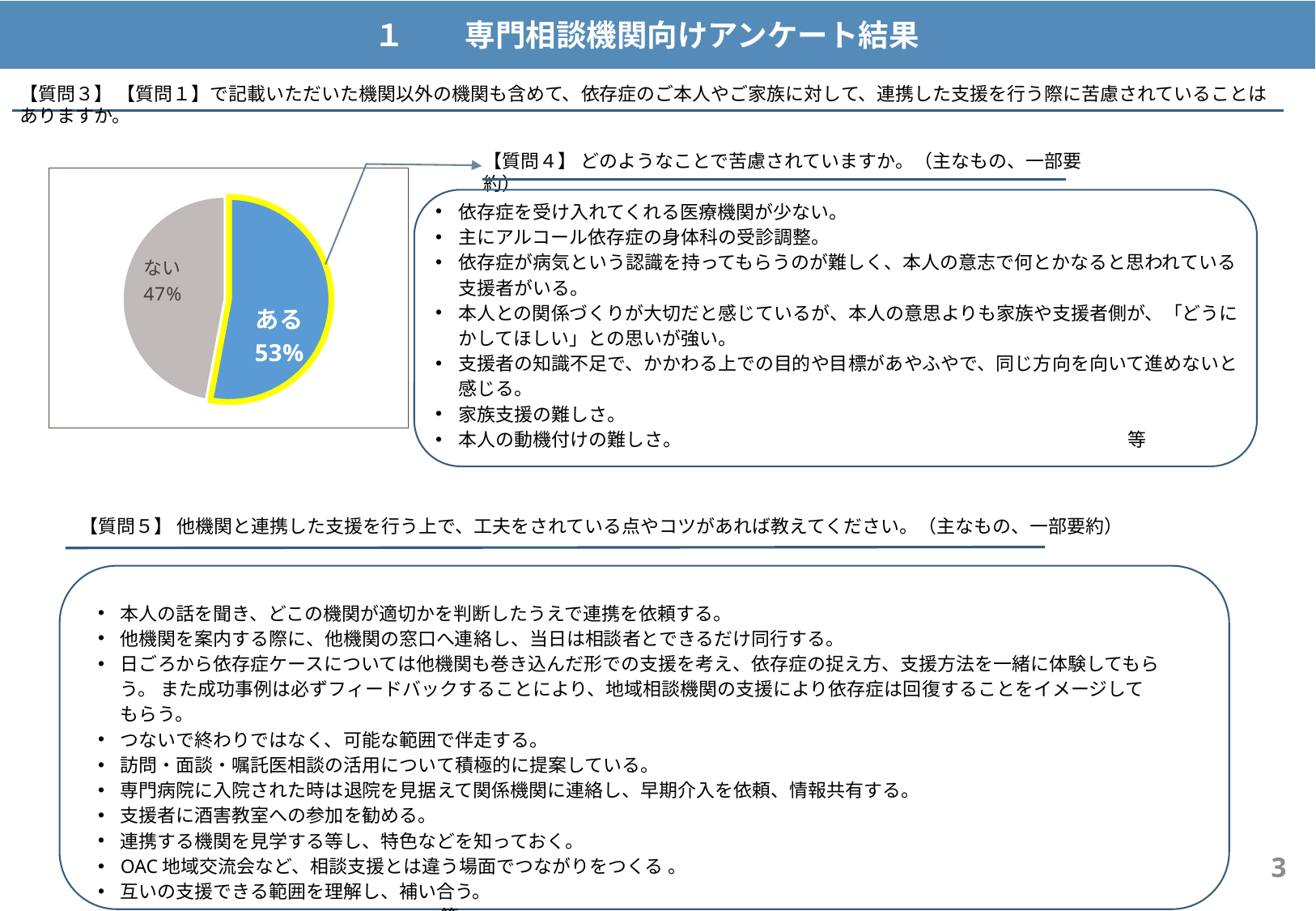
Is the value for ない in the pie chart greater or less than 50%? less What share of the pie does the ある slice represent? 53% What colour is the ない slice in the pie chart? grey What kind of chart is shown on the slide? pie chart Which slice of the pie chart is the largest? ある What is the value for ない in the pie chart? 47% What is the value for ある in the pie chart? 53% Which slice of the pie chart is the smallest? ない What is the difference between the ある and ない slices in the pie chart? 6% Which is larger in the pie chart, ある or ない? ある How many slices does the pie chart have? 2 What colour is the ある slice in the pie chart? blue